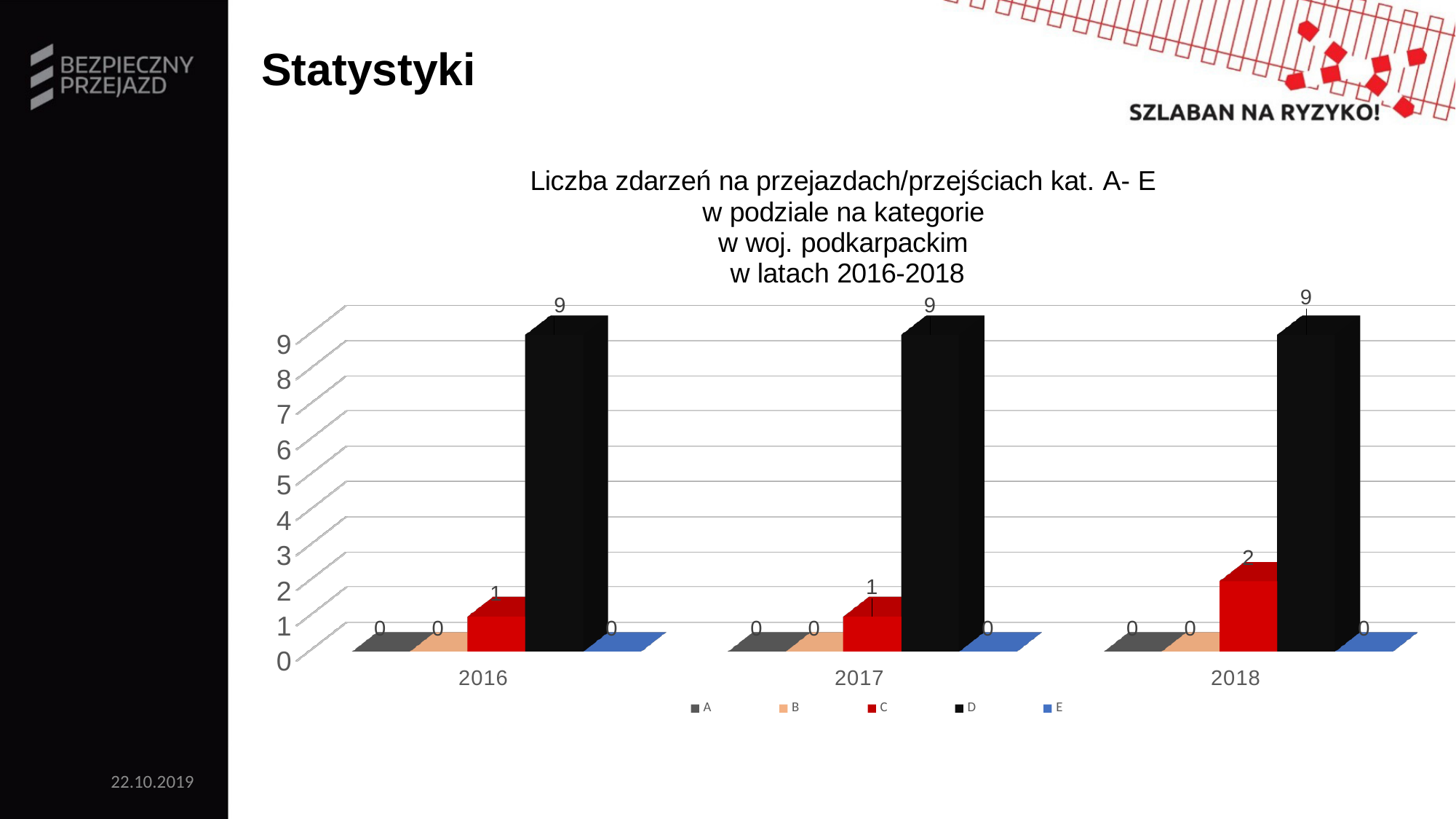
Which is larger in 2017: category C or category D? D What kind of chart is shown on the slide? bar chart What is the difference between category D and category C in 2018? 7 What is the value for category A in 2018? 0 Does the value for category C rise or fall from 2017 to 2018? rise Which colour represents category D in the legend? black How many series does the legend list? 5 What is the value for category C in 2017? 1 What is the value for category D in 2016? 9 How many years are shown on the x axis? 3 What is the value for category C in 2018? 2 Which category has the highest value in 2018? D